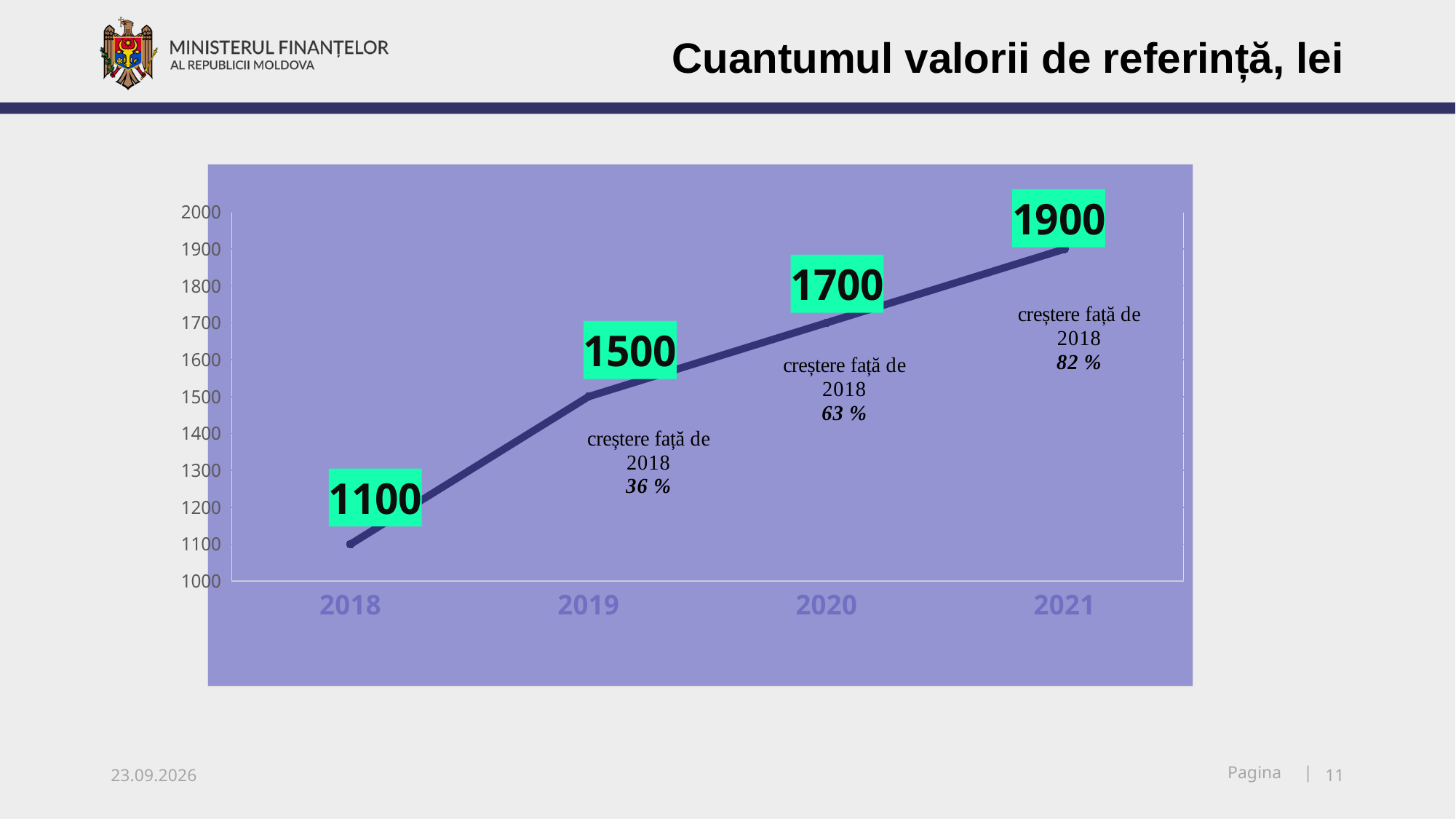
What kind of chart is shown on the slide? line chart What is the difference between the values for 2020 and 2019? 200 What is the value for 2021? 1900 Which year has the highest value? 2021 What is the value for 2019? 1500 What is the value for 2020? 1700 Do the values rise or fall from 2018 to 2021? rise Which is larger, the value for 2019 or the value for 2020? 2020 What is the value for 2018? 1100 What is the difference between the values for 2021 and 2018? 800 Which year has the lowest value? 2018 How many years are plotted on the chart? 4